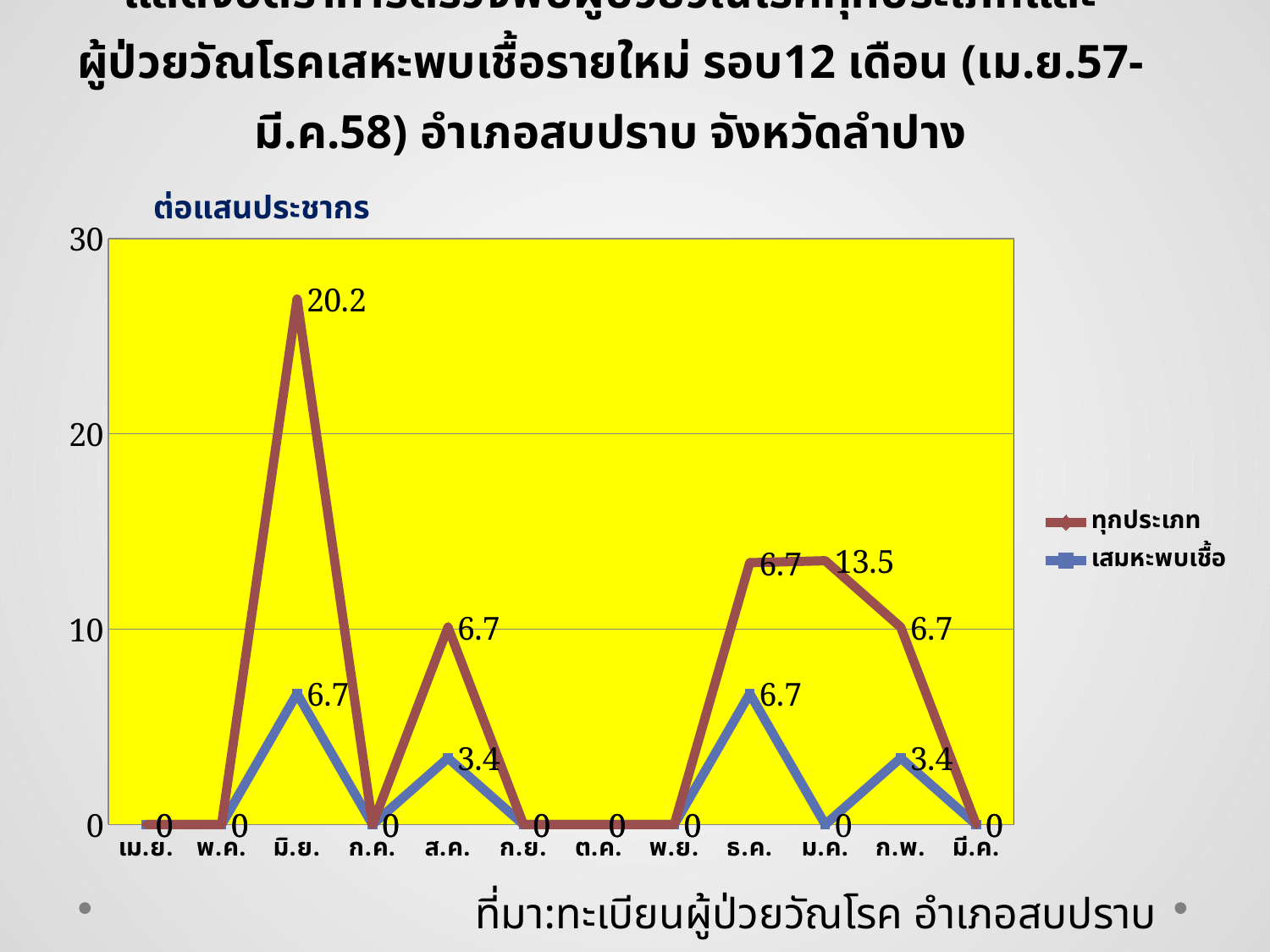
What is the value for เสมหะพบเชื้อ in ส.ค.? 3.4 What is the value for เสมหะพบเชื้อ in มิ.ย.? 6.7 In ส.ค., which series has the larger value, ทุกประเภท or เสมหะพบเชื้อ? ทุกประเภท What kind of chart is shown on the slide? line chart What unit label is shown above the y axis? ต่อแสนประชากร In which month does ทุกประเภท reach its highest value? มิ.ย. What is the value for ทุกประเภท in มิ.ย.? 20.2 What is the value for ทุกประเภท in ม.ค.? 13.5 How many months are shown along the x axis? 12 How many series does the legend list? 2 What is the difference between ทุกประเภท and เสมหะพบเชื้อ in มิ.ย.? 13.5